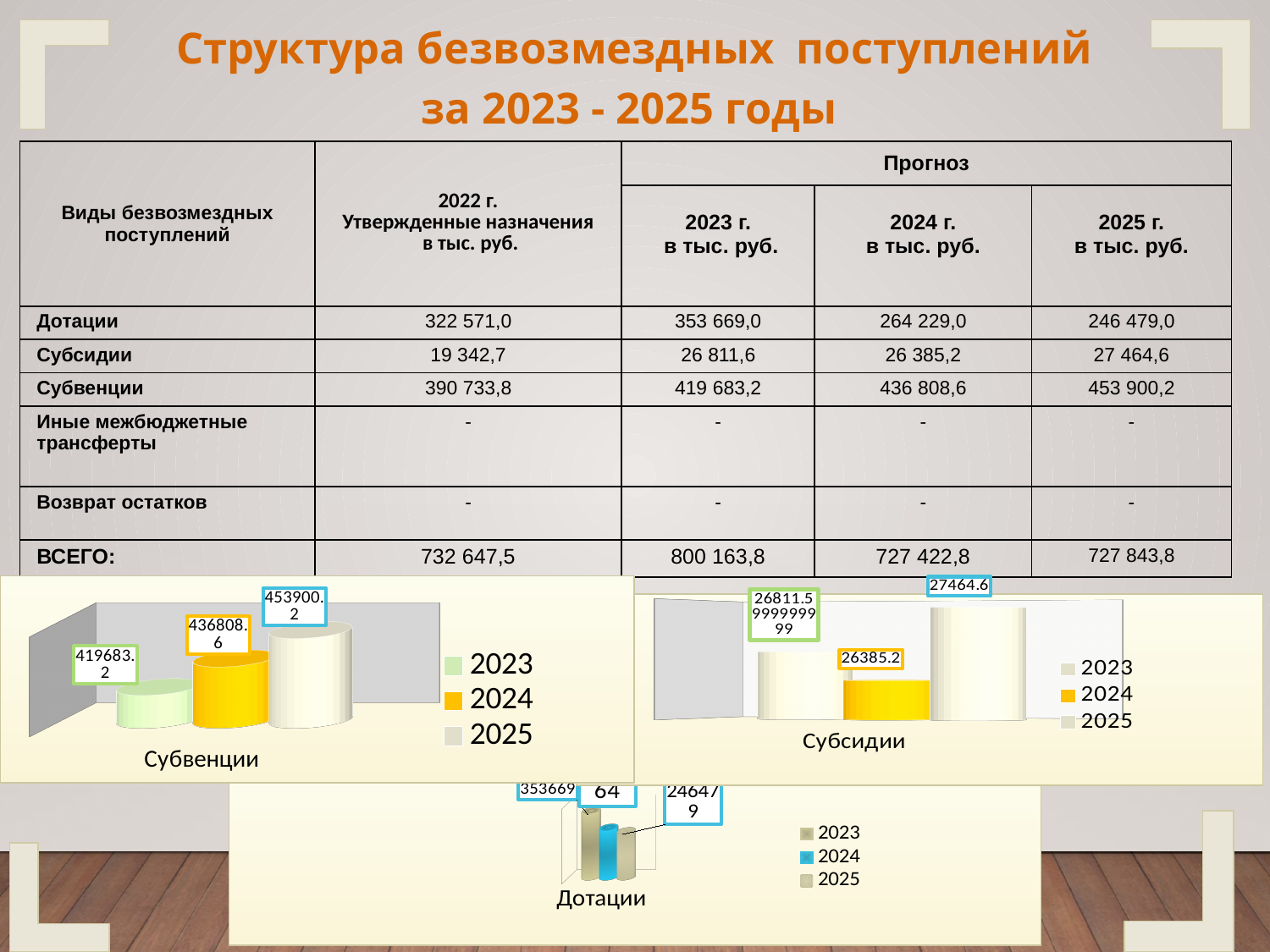
In the Субсидии chart, what is the difference between the 2025 and 2024 values? 1079.4 In the Субвенции chart, what is the value for 2023? 419683.2 In the Субвенции chart, what is the difference between the 2025 and 2024 values? 17091.6 In the Субсидии chart, which year has the highest value? 2025 In the Субвенции chart, what is the value for 2025? 453900.2 In the Субвенции chart, which year has the lowest value? 2023 In the Субвенции chart, which year has the highest value? 2025 In the Дотации chart, what is the value for 2023? 353669 How many series does the legend of the Субвенции chart list? 3 In the Субсидии chart, what is the value for 2024? 26385.2 What kind of chart is the Субвенции chart? bar chart In the Субвенции chart, do the values rise or fall from 2023 to 2025? rise